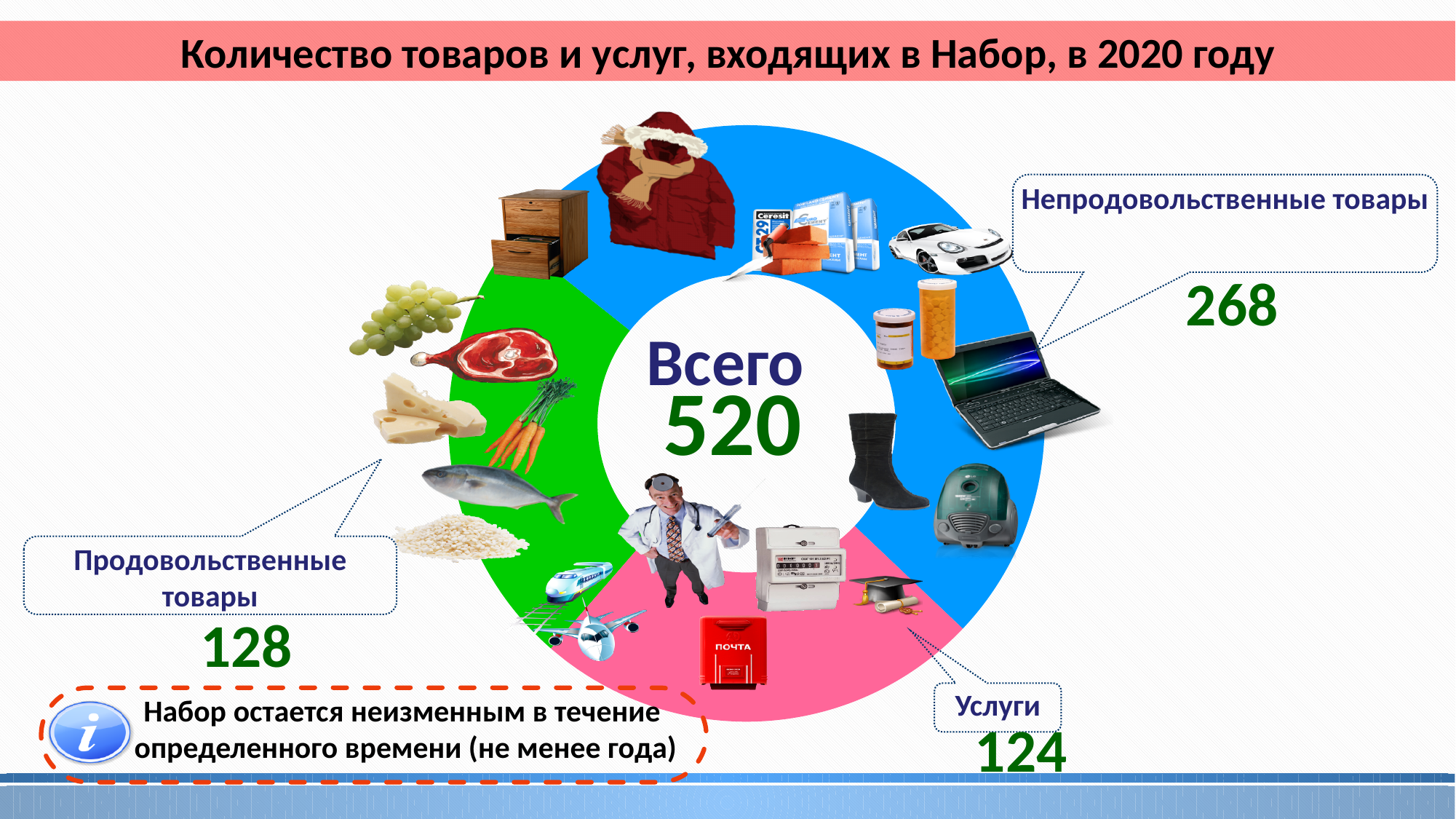
Which is larger: Продовольственные товары or Услуги? Продовольственные товары What is the difference between Продовольственные товары and Услуги? 4 What is the difference between Непродовольственные товары and Продовольственные товары? 140 What is the total number shown in the centre of the chart (Всего)? 520 What is the title of the slide? Количество товаров и услуг, входящих в Набор, в 2020 году How many items are in the category Услуги? 124 What type of chart is shown on the slide? Donut (pie) chart Which category has the smallest number of items? Услуги Which category has the largest number of items? Непродовольственные товары How many items are in the category Непродовольственные товары? 268 How many categories does the chart show? 3 How many items are in the category Продовольственные товары? 128